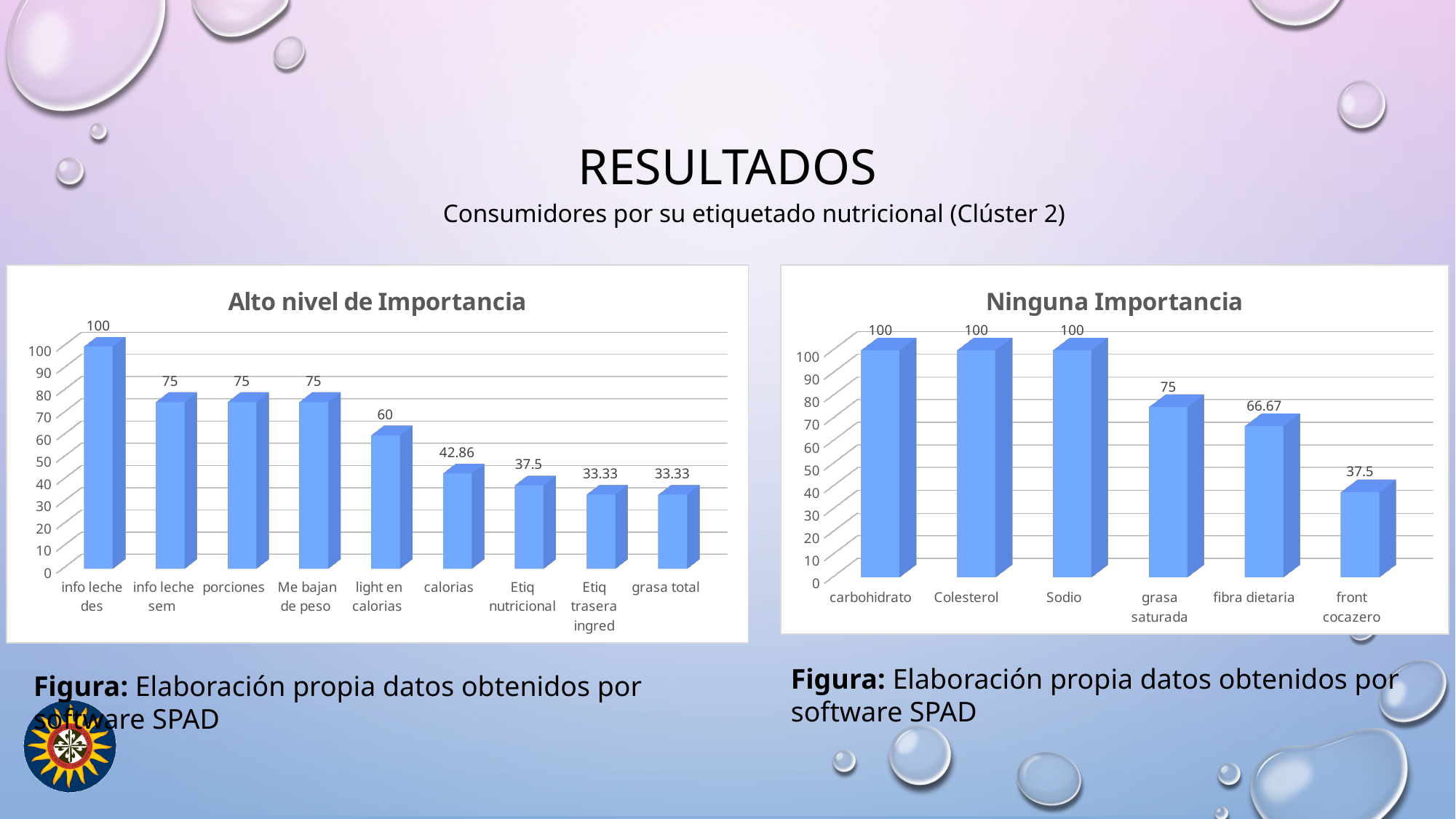
In the 'Alto nivel de Importancia' chart, how many categories are shown? 9 In the 'Alto nivel de Importancia' chart, what is the value for 'light en calorias'? 60 In the 'Alto nivel de Importancia' chart, which category has the highest value? info leche des In the 'Ninguna Importancia' chart, which category has the lowest value? front cocazero In the 'Alto nivel de Importancia' chart, which is larger: 'porciones' or 'calorias'? porciones What kind of chart is the 'Ninguna Importancia' chart? Bar chart In the 'Alto nivel de Importancia' chart, what is the value for 'calorias'? 42.86 In the 'Ninguna Importancia' chart, what is the value for 'fibra dietaria'? 66.67 In the 'Ninguna Importancia' chart, do the values rise or fall from left to right? Fall In the 'Ninguna Importancia' chart, what is the difference between 'grasa saturada' and 'front cocazero'? 37.5 In the 'Alto nivel de Importancia' chart, what is the difference between 'info leche des' and 'Etiq nutricional'? 62.5 In the 'Ninguna Importancia' chart, how many categories are shown? 6